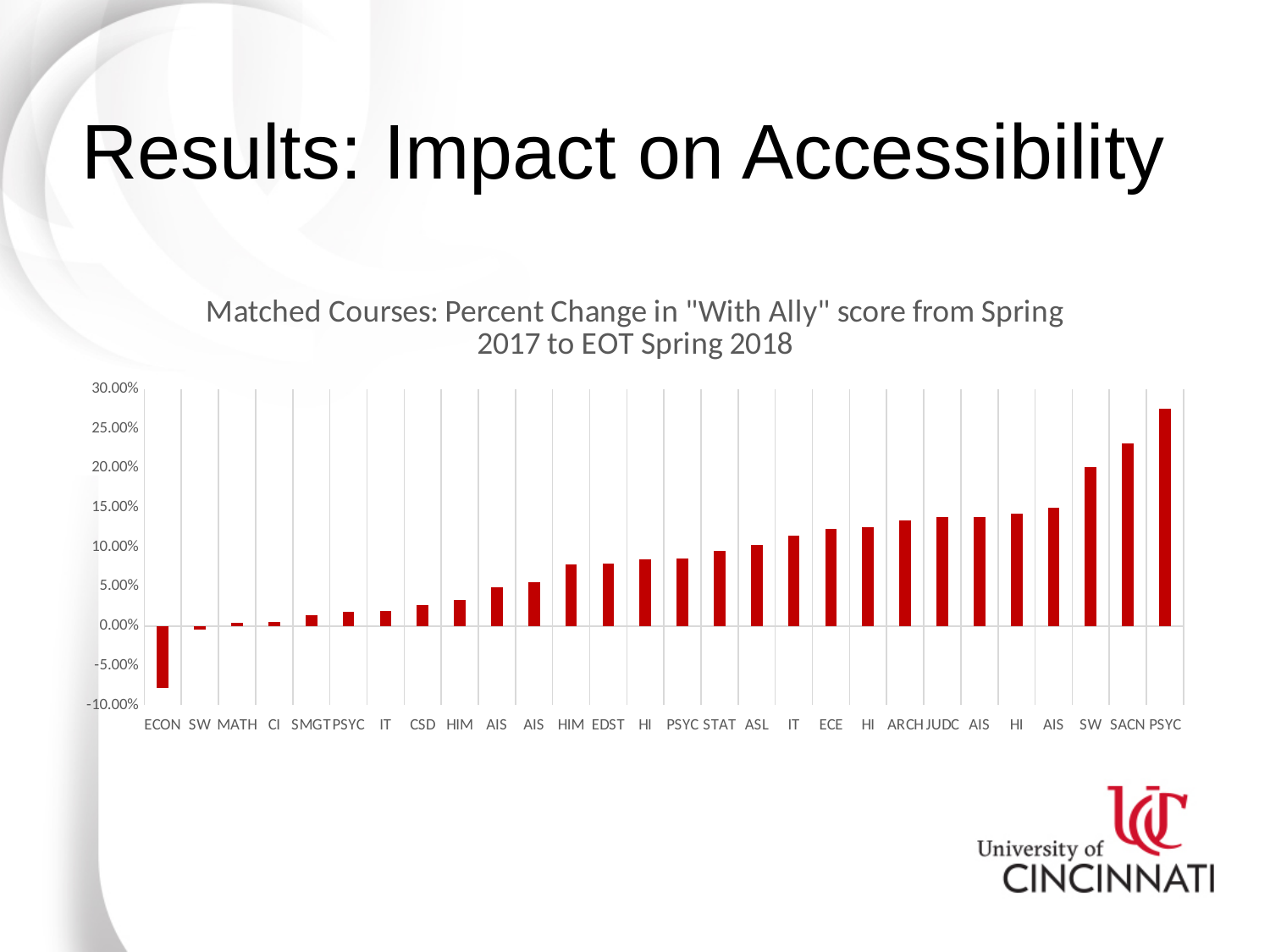
Is the value for ECON greater or less than -5.00%? less Is the value for CSD greater or less than 5.00%? less Which has the larger value, ECE or CSD? ECE Is the value for SACN greater or less than 20.00%? greater Which category has the highest value in the chart? PSYC (rightmost bar) How many bars are plotted in the chart? 28 What is the title of the chart? Matched Courses: Percent Change in "With Ally" score from Spring 2017 to EOT Spring 2018 Do the bar values generally rise or fall from left to right along the x axis? rise What kind of chart is shown on the slide? bar chart Which category has the lowest value in the chart? ECON